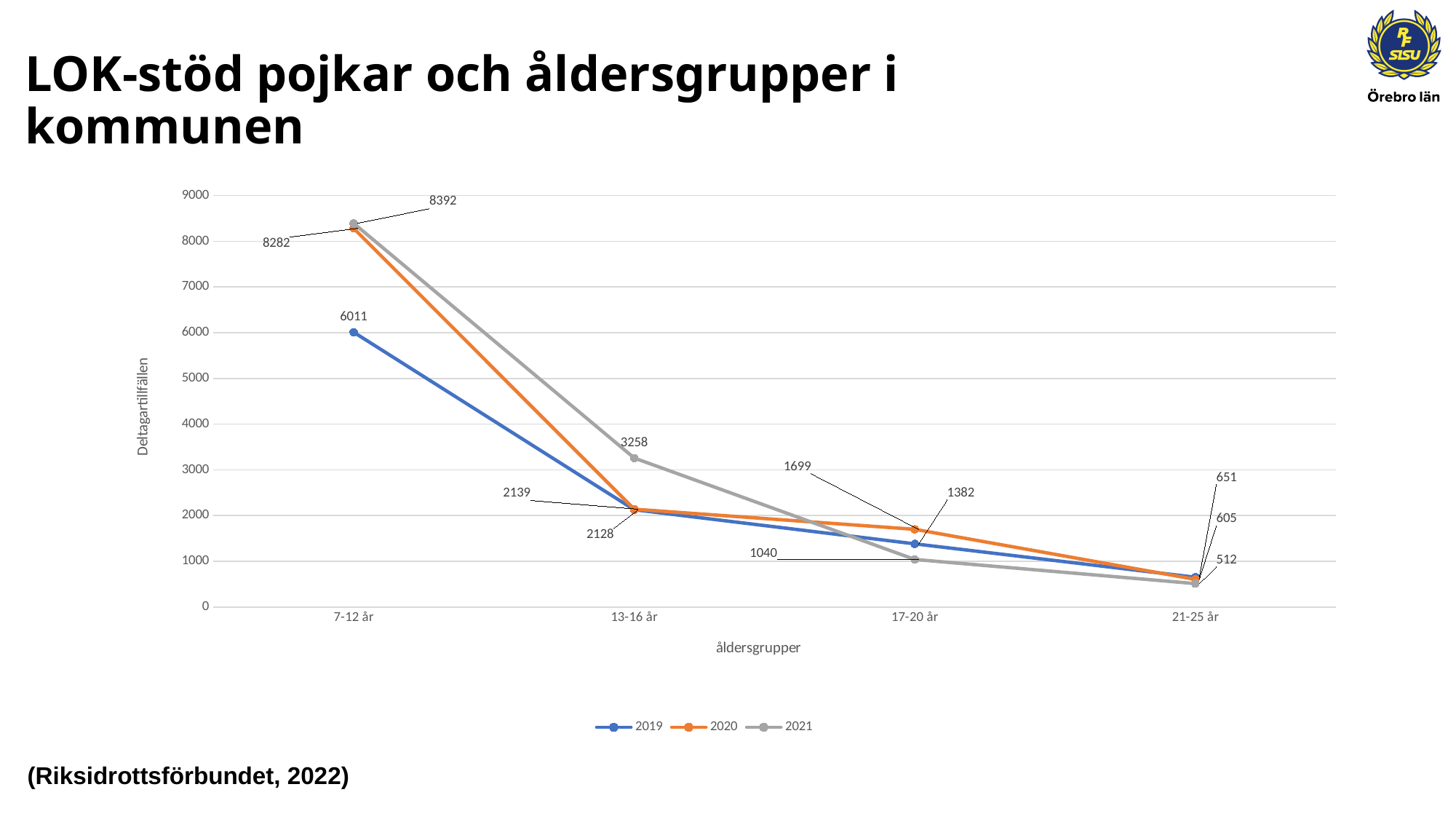
What is the value for 2021 in the 17-20 år age group? 1040 In the 17-20 år age group, which series has the larger value, 2020 or 2021? 2020 What is the difference between the 2021 and 2019 values in the 7-12 år age group? 2381 What is the value for 2021 in the 13-16 år age group? 3258 Which age group has the highest value for 2021? 7-12 år What kind of chart is shown on the slide? Line chart How many series does the legend list? 3 What is the value for 2021 in the 7-12 år age group? 8392 What is the value for 2019 in the 7-12 år age group? 6011 What is the value for 2020 in the 17-20 år age group? 1699 Do the values for 2021 rise or fall as the age groups increase along the x axis? Fall How many age groups are shown on the x axis? 4